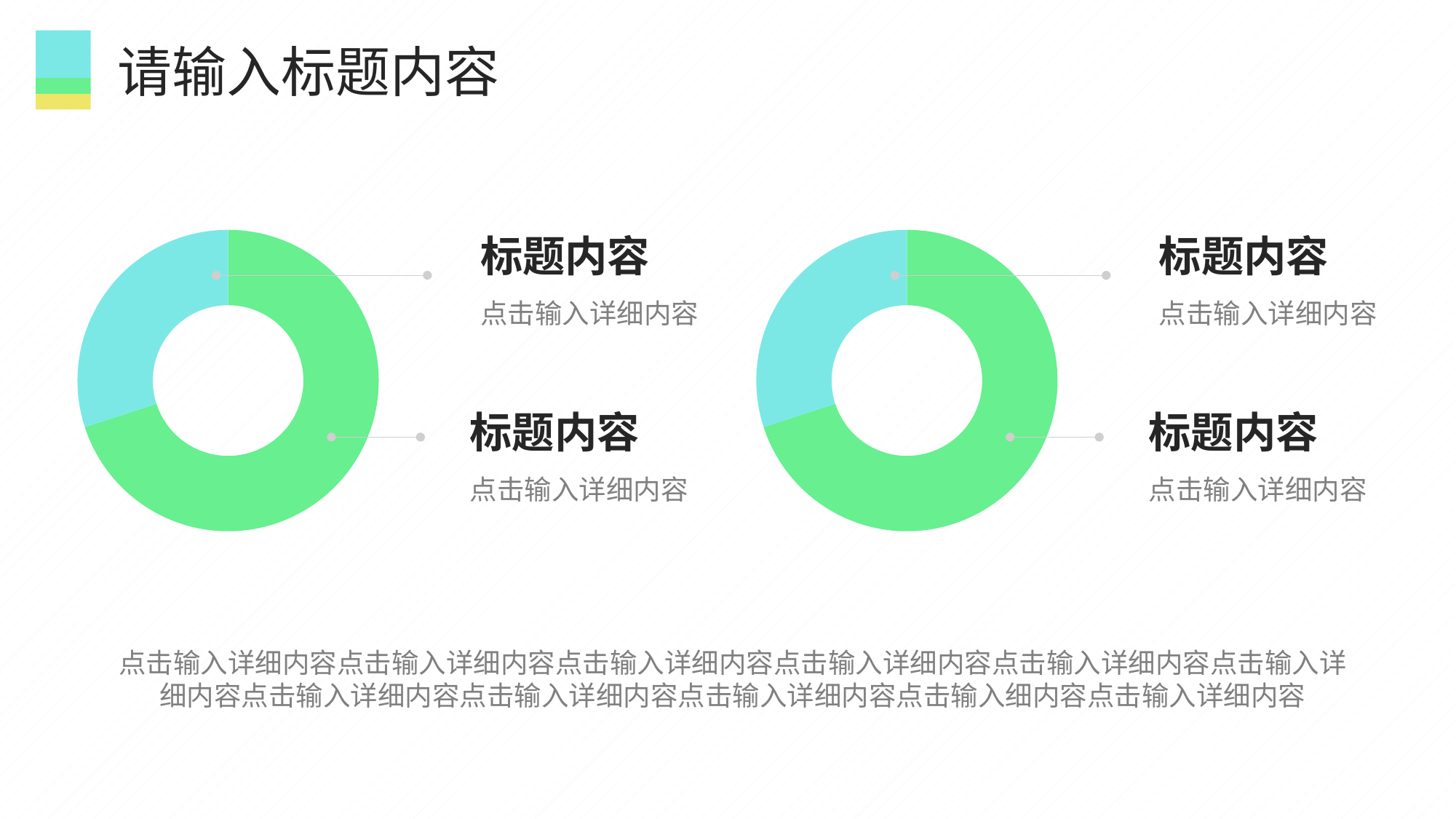
In the left chart, which slice is larger, the green one or the cyan one? The green one In the right chart, how many slices does the donut have? 2 In the right chart, is the cyan slice's share of the donut greater or less than 50%? less How many charts are shown on the slide? 2 In the right chart, which slice is larger, the green one or the cyan one? The green one What two colours are used for the slices in the left chart? Green and cyan What is the title text at the top of the slide? 请输入标题内容 What kind of chart is the chart on the left side of the slide? Donut chart In the left chart, is the green slice's share of the donut greater or less than 50%? greater In the left chart, how many slices does the donut have? 2 What kind of chart is the chart on the right side of the slide? Donut chart